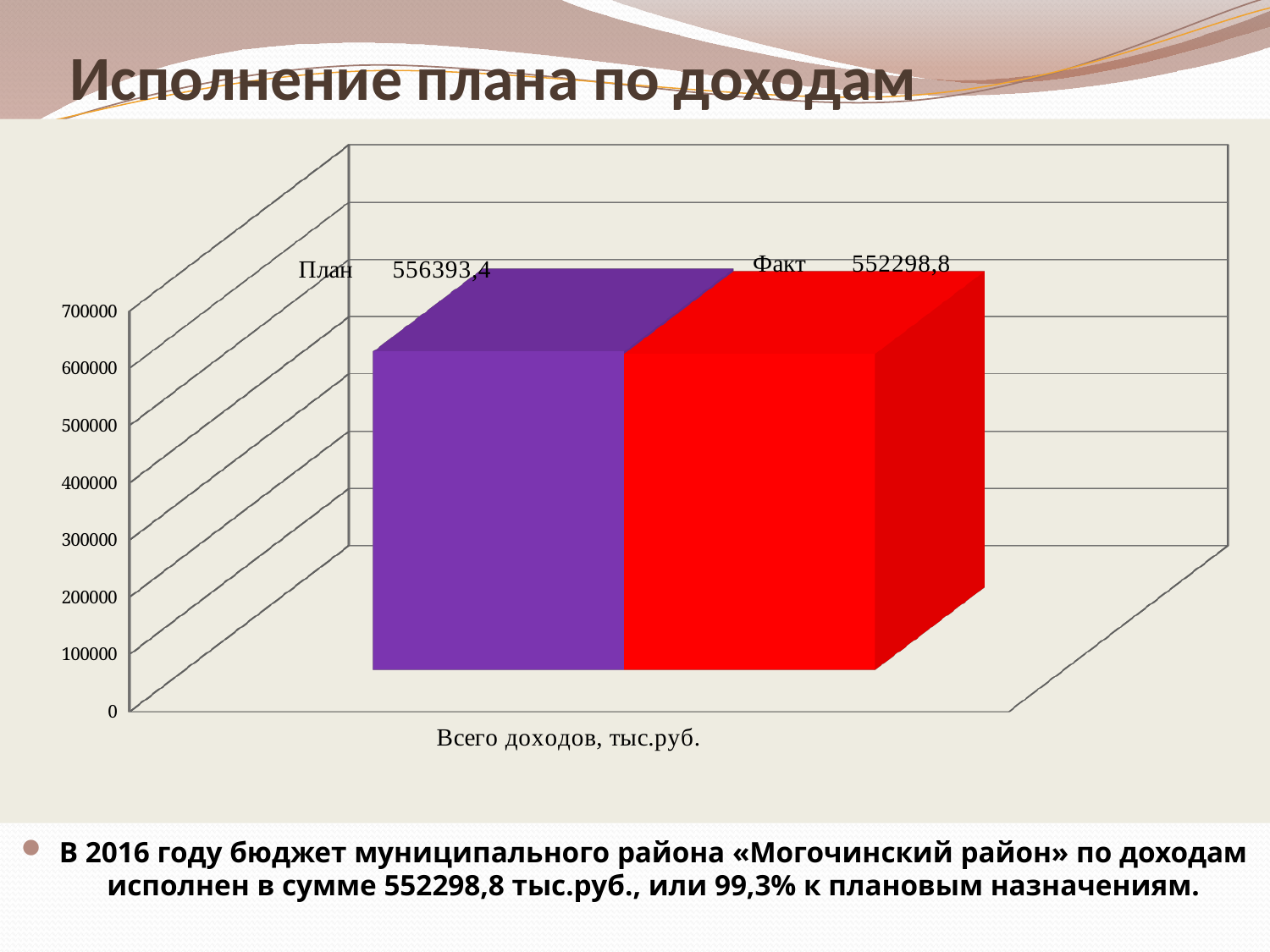
What is the category label shown on the x axis of the chart? Всего доходов, тыс.руб. What is the value for Факт (actual) on the chart? 552298,8 What is the value for План (plan) on the chart? 556393,4 How many series (bars) are plotted on the chart? 2 Which series has the lowest value on the chart? Факт Is the value for План greater or less than 500000? greater How many categories are shown on the x axis of the chart? 1 What kind of chart is shown on the slide? Bar chart Is the value for Факт greater or less than 600000? less What is the difference between the План value and the Факт value? 4094,6 Which series has the higher value, План or Факт? План What is the title of the slide containing the chart? Исполнение плана по доходам